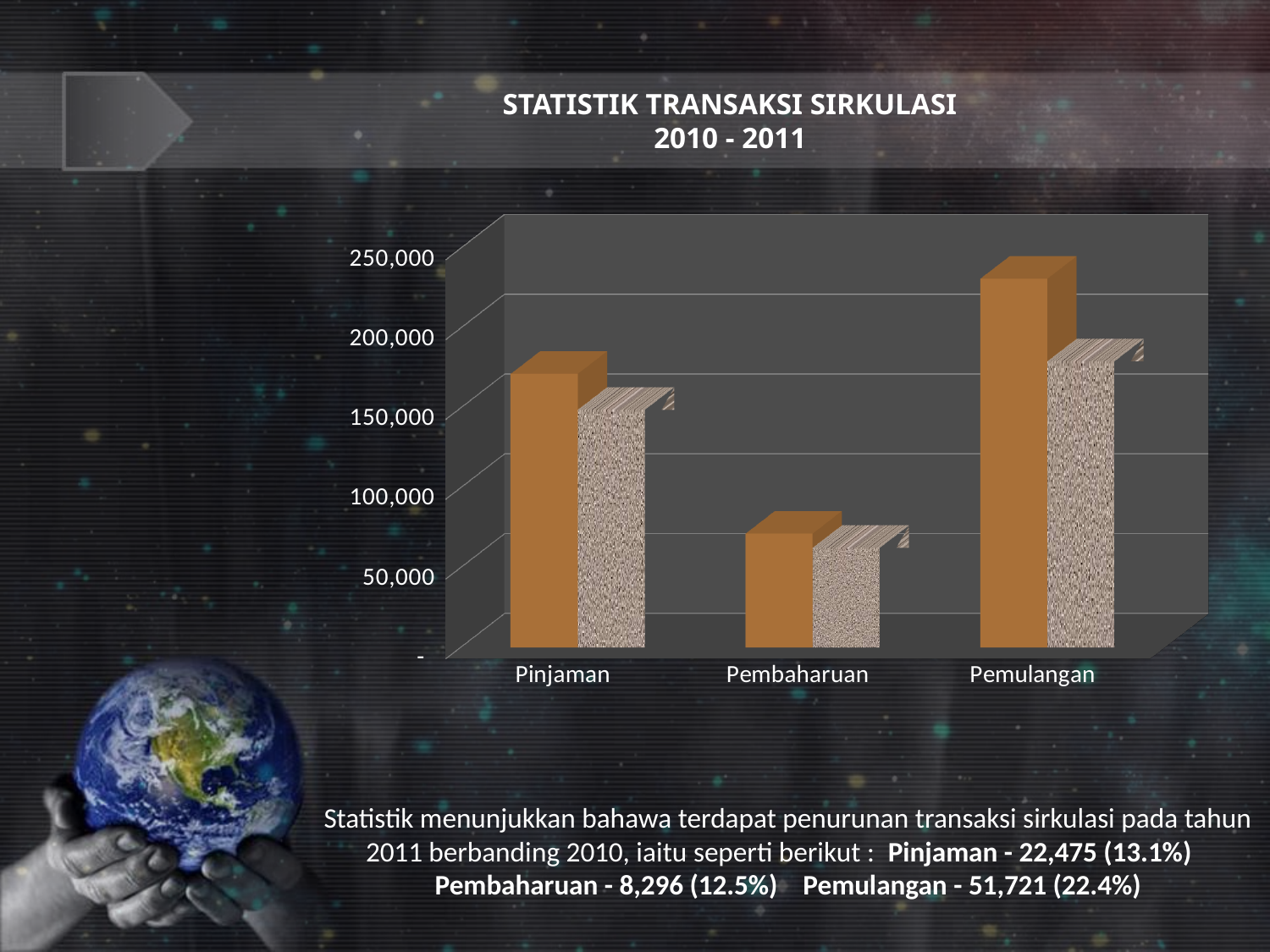
What is the title of the chart? STATISTIK TRANSAKSI SIRKULASI 2010 - 2011 Is the value of the solid orange bar for Pinjaman greater or less than 150,000? greater Which category has a larger solid orange bar: Pinjaman or Pembaharuan? Pinjaman Which category has the tallest bars in the chart? Pemulangan Which category has the shortest bars in the chart? Pembaharuan According to the text on the slide, by how much did Pemulangan transactions decrease in 2011 compared with 2010? 51,721 (22.4%) What kind of chart is shown on the slide? bar chart How many categories are shown on the x axis of the chart? 3 Is the value of the solid orange bar for Pemulangan greater or less than 200,000? greater Is the value of the solid orange bar for Pembaharuan greater or less than 100,000? less Within the Pinjaman category, which bar is taller: the solid orange bar or the textured bar? the solid orange bar